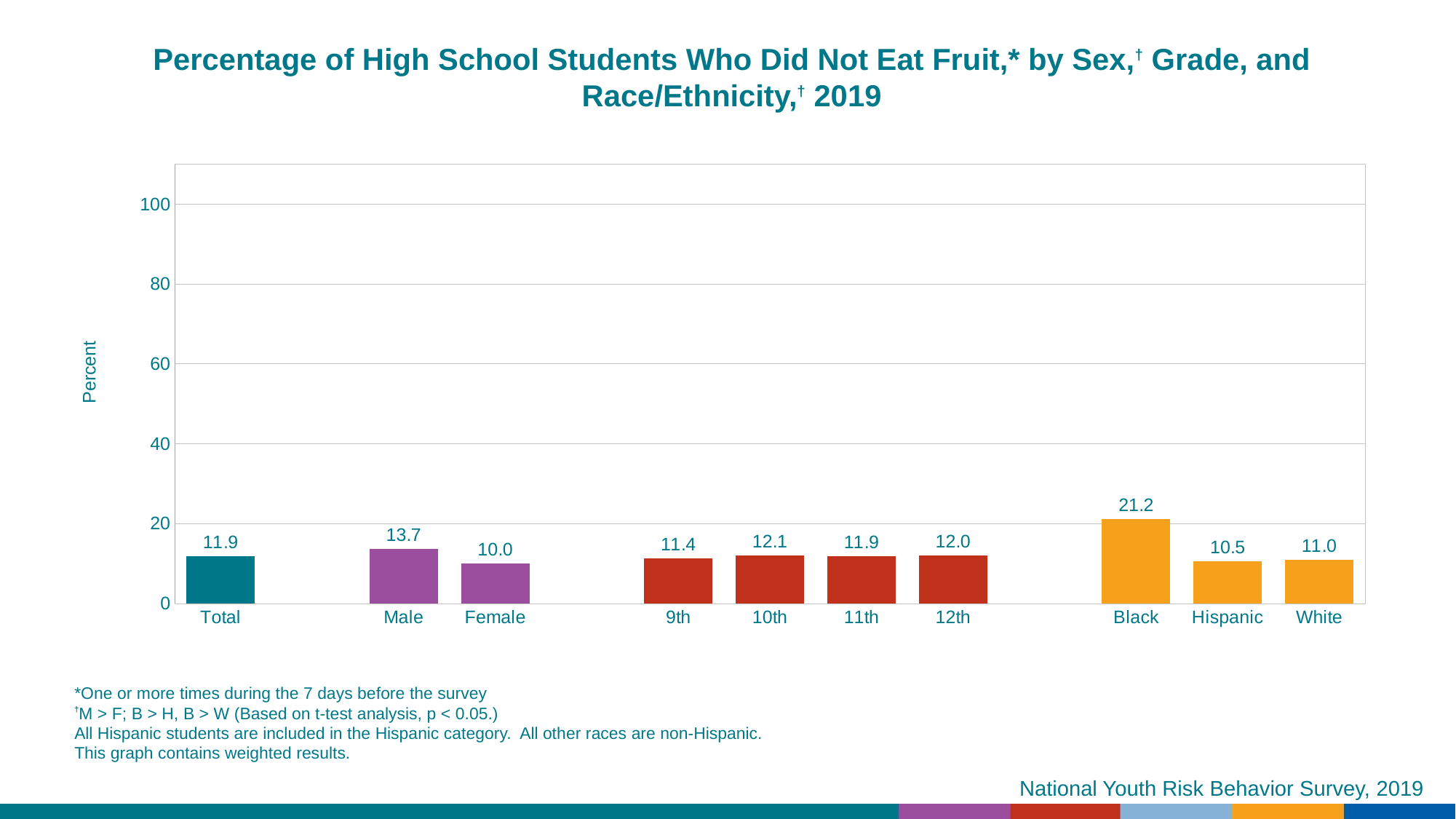
What is the value for Total? 11.9 What is the difference between the Black and Hispanic values? 10.7 What is the difference between the Male and Female values? 3.7 What is the label of the y axis? Percent What percentage of Male students did not eat fruit? 13.7 Which is larger, the value for 10th grade or the value for 9th grade? 10th Which category has the lowest value? Female What kind of chart is this? bar chart Which category has the highest value? Black What is the value for Black students? 21.2 How many categories are shown on the x axis? 10 Is the value for Black greater or less than 20? greater